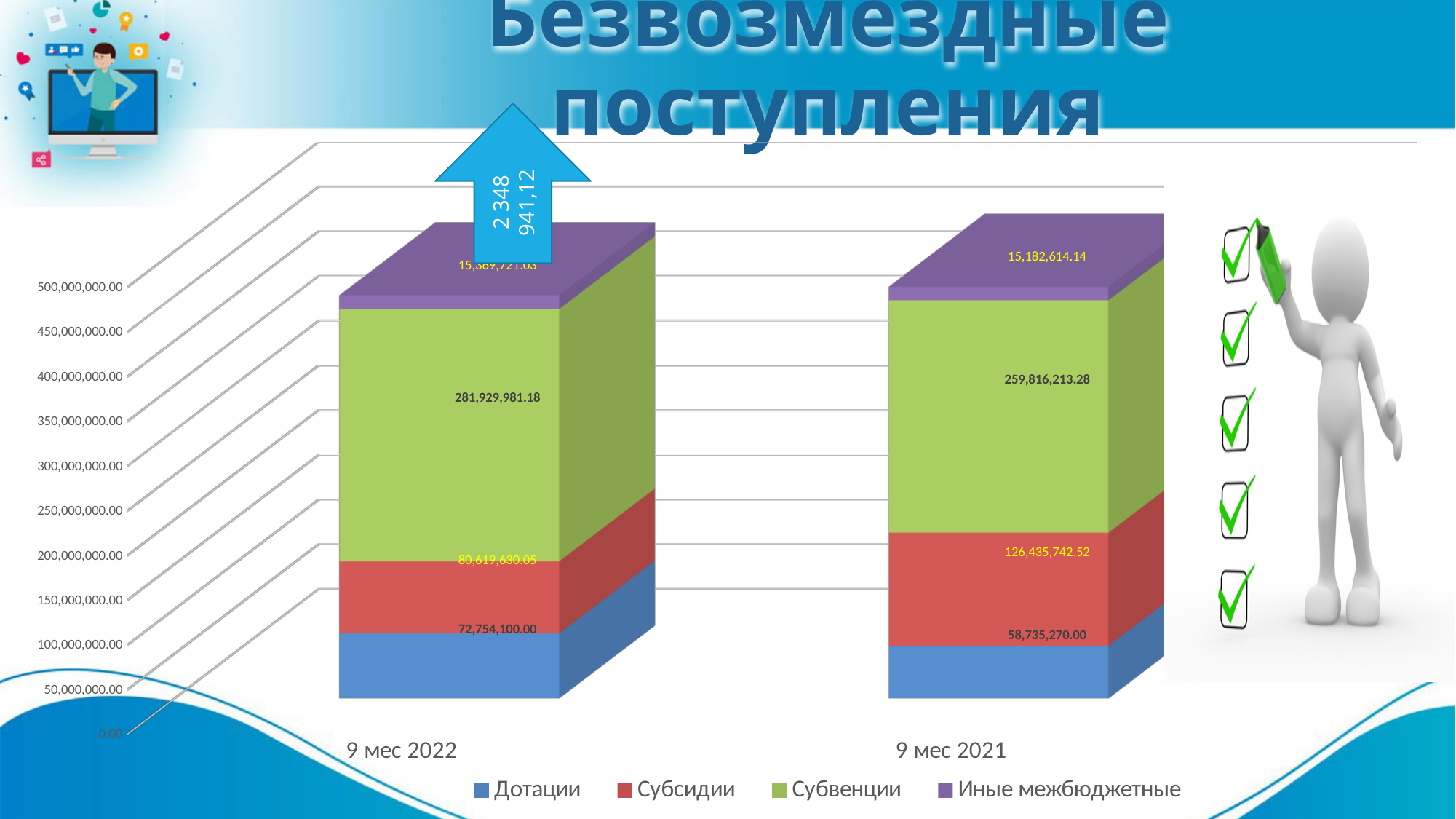
What is the value of Иные межбюджетные for 9 мес 2021? 15,182,614.14 What is the value of Субвенции for 9 мес 2022? 281,929,981.18 What is the total of the 9 мес 2021 stacked bar? 460,169,839.94 What is the value of Дотации for 9 мес 2022? 72,754,100.00 Which series has the largest value in the 9 мес 2021 bar? Субвенции What is the value of Субсидии for 9 мес 2021? 126,435,742.52 What is the difference between the Субсидии values for 9 мес 2021 and 9 мес 2022? 45,816,112.47 How many series does the legend list? 4 Which is larger: Дотации for 9 мес 2022 or Дотации for 9 мес 2021? 9 мес 2022 What kind of chart is shown on the slide? Stacked bar chart Which series has the smallest value in the 9 мес 2022 bar? Иные межбюджетные What is the difference between the Субвенции values for 9 мес 2022 and 9 мес 2021? 22,113,767.90